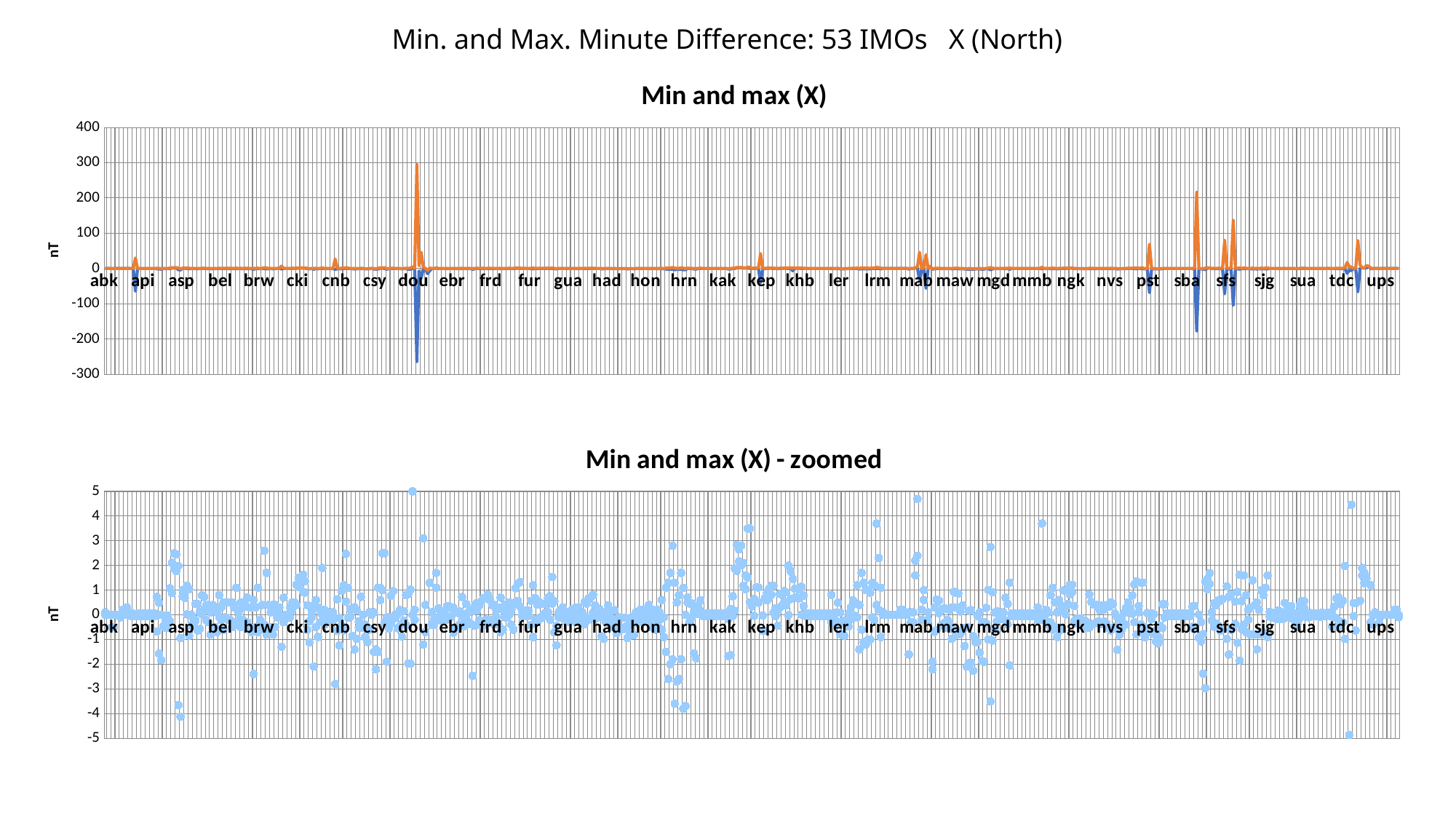
In the 'Min and max (X)' chart, at which station does the blue series reach its lowest value? dou What is the y-axis label on the 'Min and max (X) - zoomed' chart? nT What is the title of the upper chart? Min and max (X) In the 'Min and max (X)' chart, is the blue minimum at dou greater or less than -200? less What kind of chart is the lower 'Min and max (X) - zoomed' chart? scatter chart In the 'Min and max (X)' chart, is the orange peak at sba greater or less than 100? greater In the 'Min and max (X)' chart, which orange peak is higher, the one at dou or the one at sfs? dou What kind of chart is the upper 'Min and max (X)' chart? line chart In the 'Min and max (X)' chart, is the orange peak at pst greater or less than 100? less In the 'Min and max (X)' chart, at which station does the orange series reach its highest peak? dou